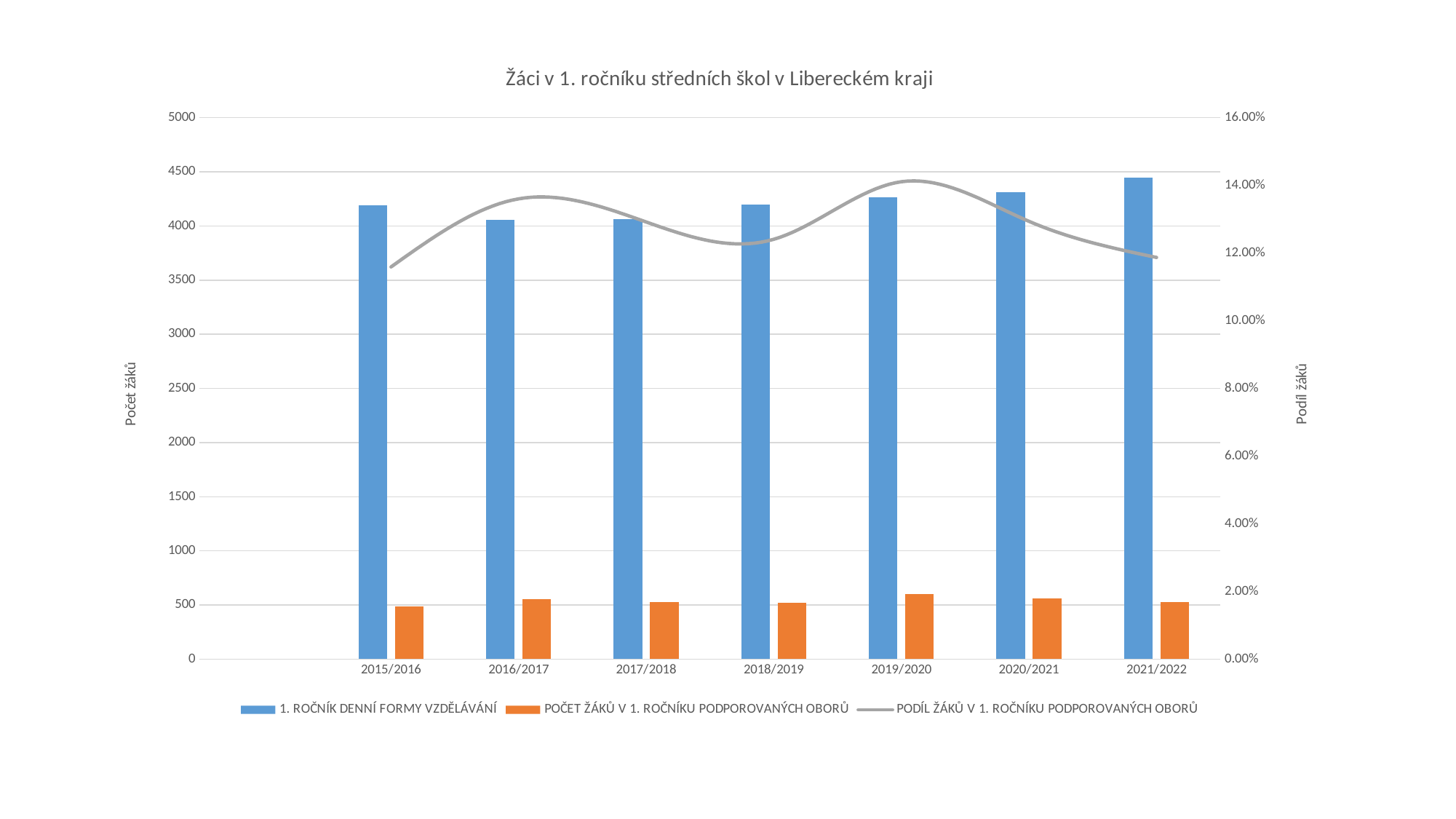
Is the value for POČET ŽÁKŮ V 1. ROČNÍKU PODPOROVANÝCH OBORŮ in 2019/2020 greater or less than 500? greater Which is larger: the 1. ROČNÍK DENNÍ FORMY VZDĚLÁVÁNÍ value in 2021/2022 or in 2016/2017? 2021/2022 Which school year has the highest value for 1. ROČNÍK DENNÍ FORMY VZDĚLÁVÁNÍ? 2021/2022 How many school years are shown on the x axis of the chart? 7 In which school year does the PODÍL ŽÁKŮ V 1. ROČNÍKU PODPOROVANÝCH OBORŮ line reach its highest point? 2019/2020 Is the PODÍL ŽÁKŮ V 1. ROČNÍKU PODPOROVANÝCH OBORŮ value in 2015/2016 greater or less than 12.00%? less What is the title of the chart? Žáci v 1. ročníku středních škol v Libereckém kraji What kind of chart is shown on the slide? Combined bar and line chart Is the value for 1. ROČNÍK DENNÍ FORMY VZDĚLÁVÁNÍ in 2021/2022 greater or less than 4000? greater Which school year has the highest value for POČET ŽÁKŮ V 1. ROČNÍKU PODPOROVANÝCH OBORŮ? 2019/2020 How many series does the legend list? 3 Do the values for 1. ROČNÍK DENNÍ FORMY VZDĚLÁVÁNÍ rise or fall from 2017/2018 to 2021/2022? rise